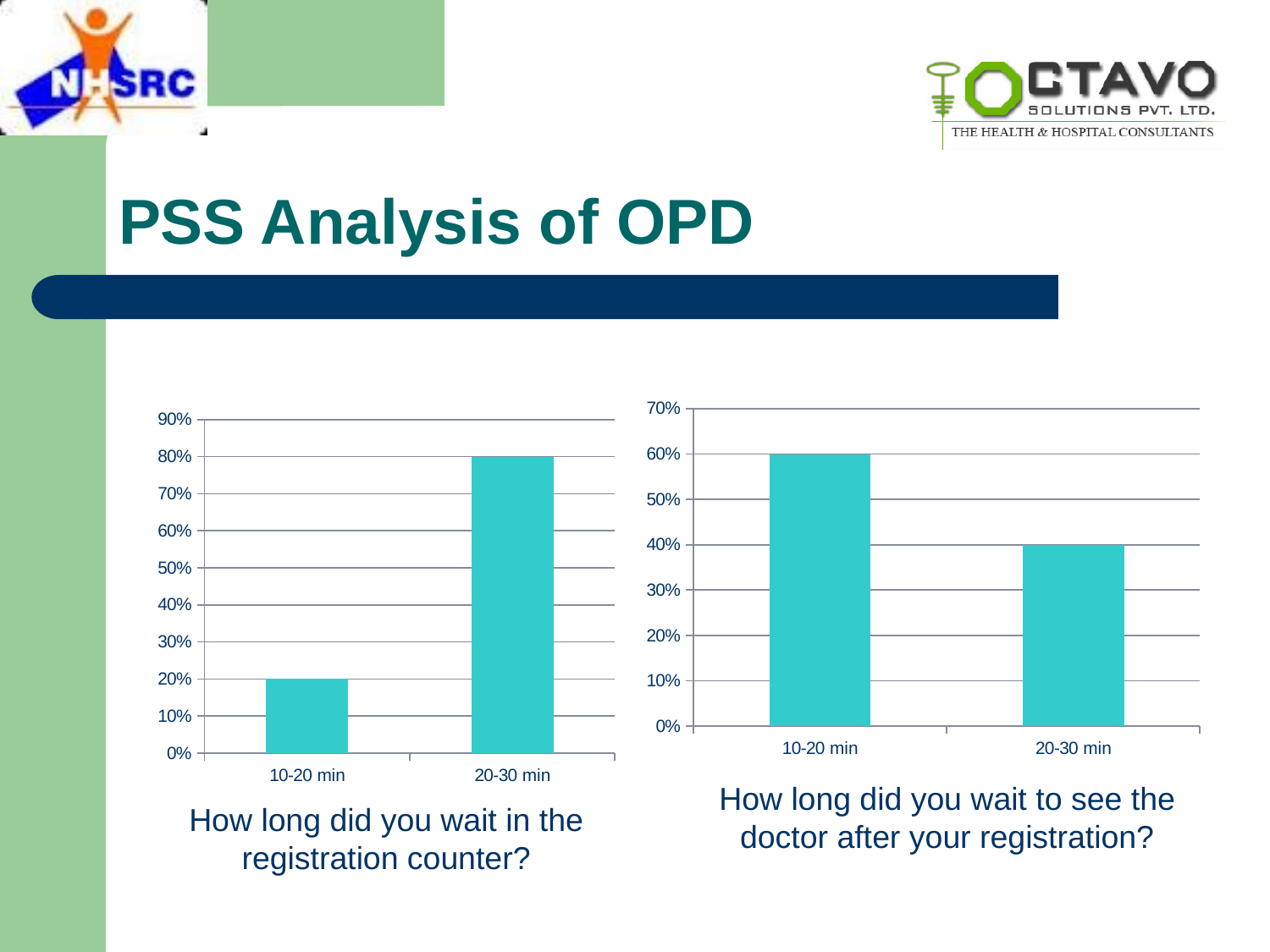
In the left chart (registration counter wait), which category has the highest value? 20-30 min How many categories are shown on the x axis of the right chart (wait to see the doctor)? 2 In the left chart (registration counter wait), is the value for 20-30 min greater or less than 50%? greater In the left chart (registration counter wait), what is the difference between the values for 20-30 min and 10-20 min? 60% In the right chart (How long did you wait to see the doctor after your registration?), what is the value for 10-20 min? 60% In the left chart (How long did you wait in the registration counter?), what is the value for 20-30 min? 80% What kind of chart is the left chart (registration counter wait)? bar chart In the right chart (How long did you wait to see the doctor after your registration?), what is the value for 20-30 min? 40% In the right chart (wait to see the doctor), which category has the lowest value? 20-30 min In the left chart (How long did you wait in the registration counter?), what is the value for 10-20 min? 20% In the right chart (wait to see the doctor), what is the difference between the values for 10-20 min and 20-30 min? 20% In the right chart (wait to see the doctor), which is larger, the value for 10-20 min or for 20-30 min? 10-20 min